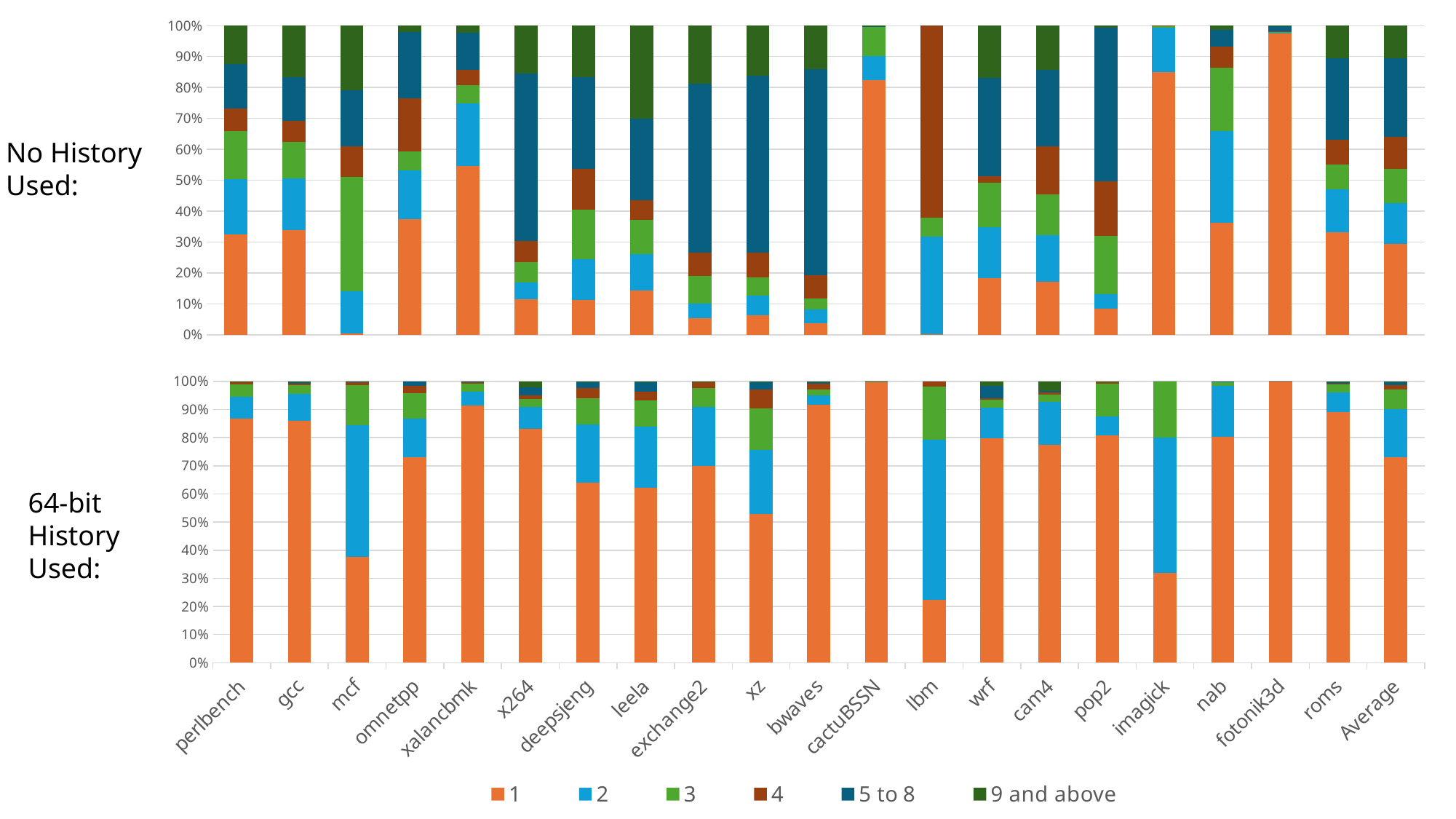
In the top chart (No History Used), is the value of series "1" for mcf greater or less than 10%? less How many series does the legend list? 6 Which series in the legend is shown in orange? 1 In the bottom chart (64-bit History Used), is the value of series "1" for fotonik3d greater or less than 90%? greater In the bottom chart (64-bit History Used), is the value of series "1" for lbm greater or less than 30%? less In the top chart (No History Used), which category has the largest segment for series "1"? fotonik3d In the bottom chart (64-bit History Used), which category has the smallest segment for series "1"? lbm How many categories are shown along the x axis of the bottom chart labelled "64-bit History Used"? 21 In the bottom chart (64-bit History Used), which has the larger value for series "1": mcf or xz? xz What kind of chart is the top chart labelled "No History Used"? Stacked bar chart